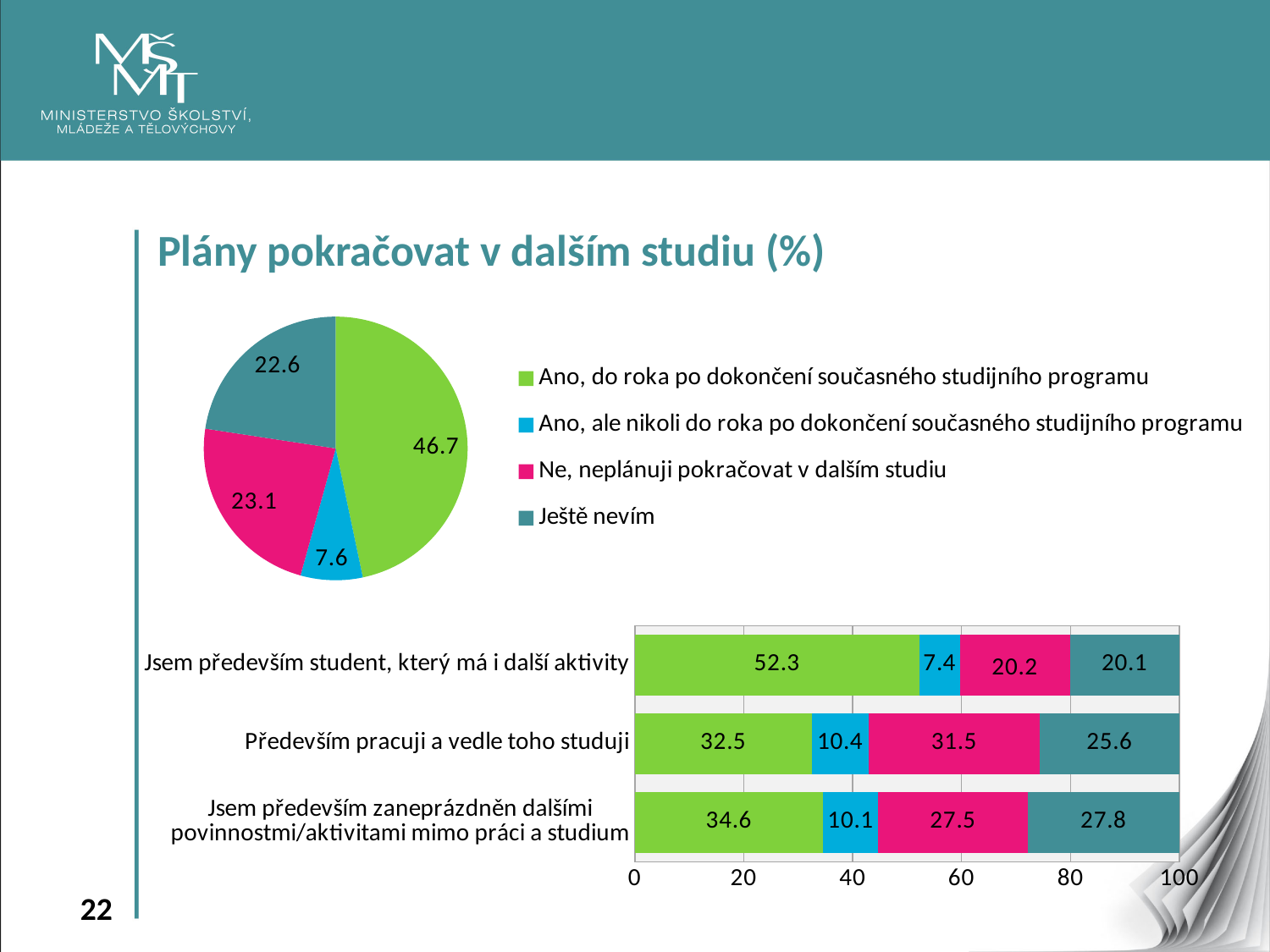
How many series does the legend list? 4 In the bottom bar chart, what is the value of 'Ne, neplánuji pokračovat v dalším studiu' for 'Především pracuji a vedle toho studuji'? 31.5 In the bottom bar chart, what is the value of 'Ano, do roka po dokončení současného studijního programu' for 'Jsem především student, který má i další aktivity'? 52.3 What kind of chart is the bottom chart on the slide? Stacked bar chart In the pie chart, what share is labelled for the slice 'Ano, do roka po dokončení současného studijního programu'? 46.7 In the pie chart, which category has the largest slice? Ano, do roka po dokončení současného studijního programu How many categories are shown in the bottom bar chart? 3 In the pie chart, which category has the smallest slice? Ano, ale nikoli do roka po dokončení současného studijního programu In the bottom bar chart, which category has the highest value for 'Ještě nevím'? Jsem především zaneprázdněn dalšími povinnostmi/aktivitami mimo práci a studium In the bottom bar chart, is the 'Ano, ale nikoli do roka po dokončení současného studijního programu' value larger for 'Především pracuji a vedle toho studuji' or for 'Jsem především student, který má i další aktivity'? Především pracuji a vedle toho studuji In the bottom bar chart, what is the difference between the 'Ano, do roka po dokončení současného studijního programu' values for 'Jsem především student, který má i další aktivity' and 'Především pracuji a vedle toho studuji'? 19.8 In the pie chart, what is the difference between the 'Ne, neplánuji pokračovat v dalším studiu' slice and the 'Ještě nevím' slice? 0.5